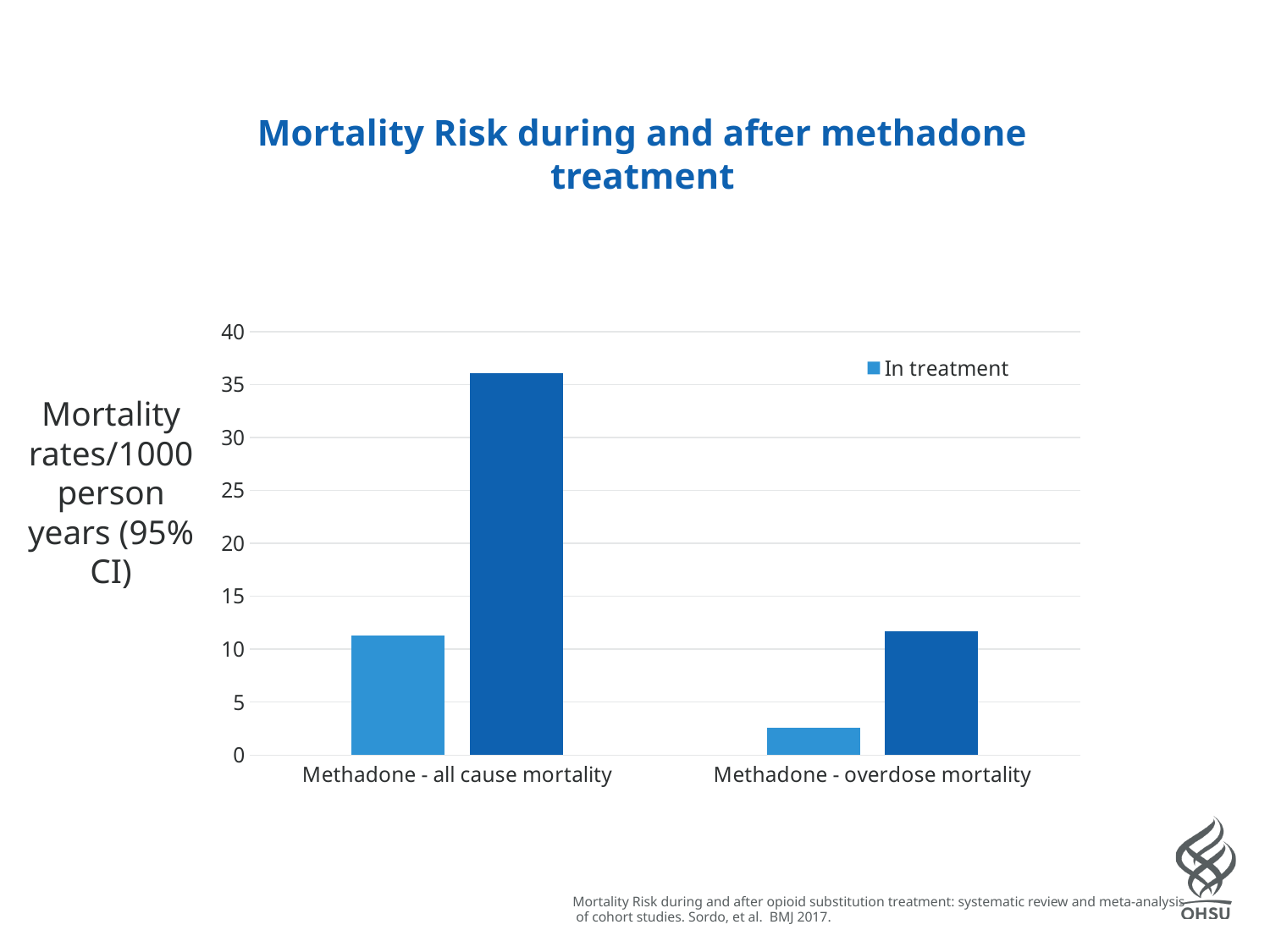
Is the tallest bar for Methadone - overdose mortality greater or less than 15? less How many categories are shown on the x axis? 2 Is the In treatment value for Methadone - all cause mortality greater or less than 10? greater How many series does the legend list? 1 What series name appears in the legend? In treatment Which category has the lowest In treatment value? Methadone - overdose mortality What is the title of the chart? Mortality Risk during and after methadone treatment Which category has the higher In treatment value, Methadone - all cause mortality or Methadone - overdose mortality? Methadone - all cause mortality Is the In treatment value for Methadone - overdose mortality greater or less than 5? less Within the Methadone - all cause mortality category, is the In treatment bar taller or shorter than the dark blue bar next to it? shorter What kind of chart is shown on the slide? bar chart